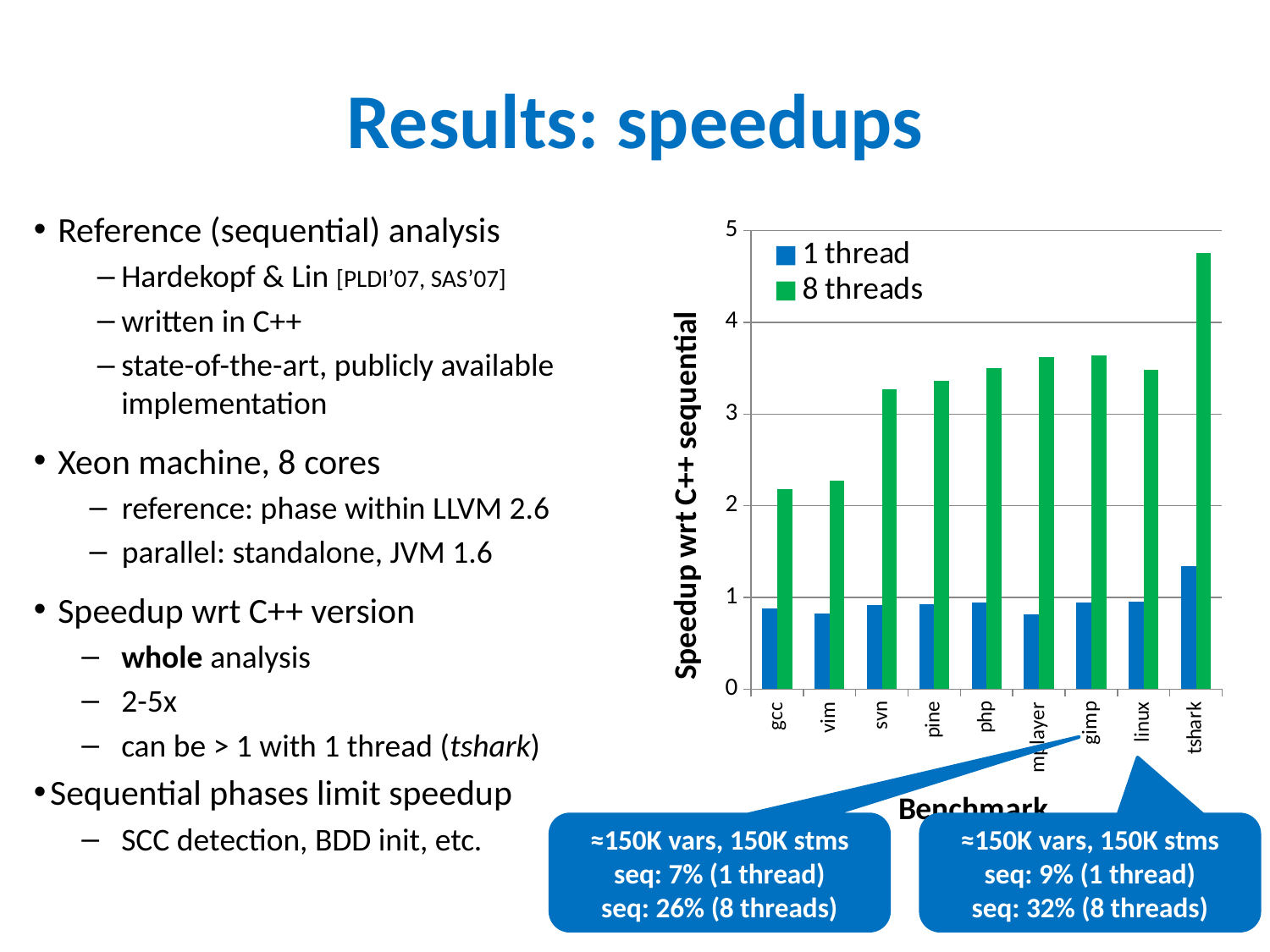
Which benchmark has the highest speedup with 8 threads? tshark Is the 1 thread speedup for tshark greater or less than 1? greater Which is larger: the 8 threads speedup for svn or the 8 threads speedup for vim? svn How many benchmarks are shown on the x axis of the chart? 9 What is the title of the chart's vertical axis? Speedup wrt C++ sequential What kind of chart is shown on the slide? bar chart Which benchmark has the highest speedup with 1 thread? tshark Is the 8 threads speedup for vim greater or less than 3? less How many series does the chart's legend list? 2 Is the 1 thread speedup for gcc greater or less than 1? less Which benchmark has the lowest speedup with 8 threads? gcc